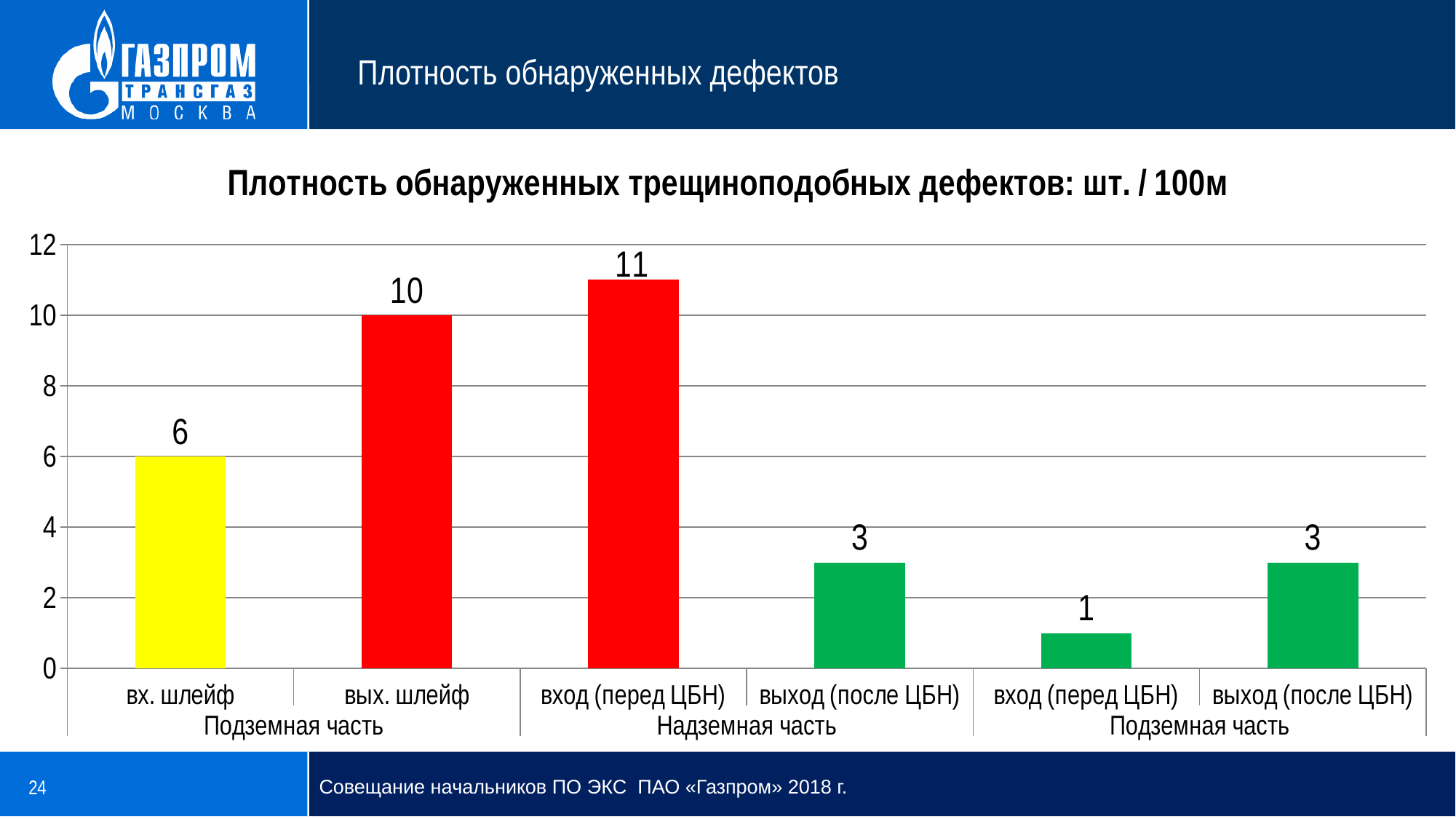
What is the value for "вх. шлейф" in the "Подземная часть" group? 6 What is the value for "вых. шлейф"? 10 Which category has the highest value? вход (перед ЦБН), Надземная часть How many bars are plotted in the chart? 6 What is the value for "вход (перед ЦБН)" in the right-hand "Подземная часть" group? 1 What is the value for "вход (перед ЦБН)" in the "Надземная часть" group? 11 Which is larger: the value for "вых. шлейф" or the value for "вход (перед ЦБН)" in the "Надземная часть" group? вход (перед ЦБН), Надземная часть Is the value for "вых. шлейф" greater or less than 8? greater What is the title of the chart? Плотность обнаруженных трещиноподобных дефектов: шт. / 100м What is the difference between the values for "вых. шлейф" and "вх. шлейф"? 4 Which category has the lowest value? вход (перед ЦБН), Подземная часть What kind of chart is shown on the slide? bar chart